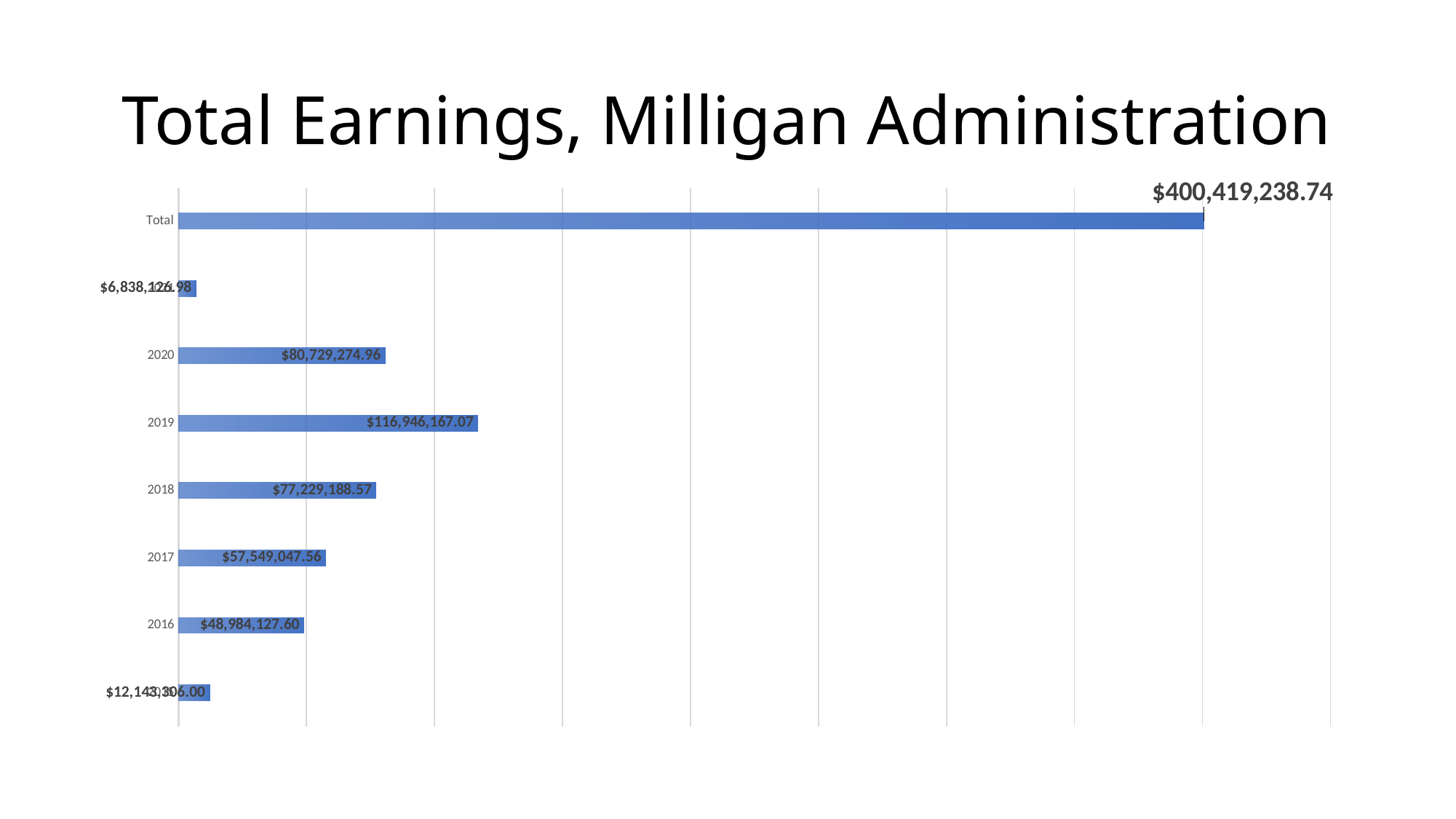
What is the value of the Total bar? $400,419,238.74 What were the total earnings in 2017? $57,549,047.56 What were the total earnings in 2020? $80,729,274.96 What were the total earnings in 2019? $116,946,167.07 What were the total earnings in 2016? $48,984,127.60 How much higher were earnings in 2019 than in 2020? $36,216,892.11 What is the difference between the 2018 and 2017 earnings? $19,680,141.01 Which year has the highest earnings? 2019 How many bars are plotted in the chart? 8 Among the years 2016 through 2020, which year has the lowest earnings? 2016 What type of chart is shown on the slide? Bar chart Which year had higher earnings, 2018 or 2020? 2020